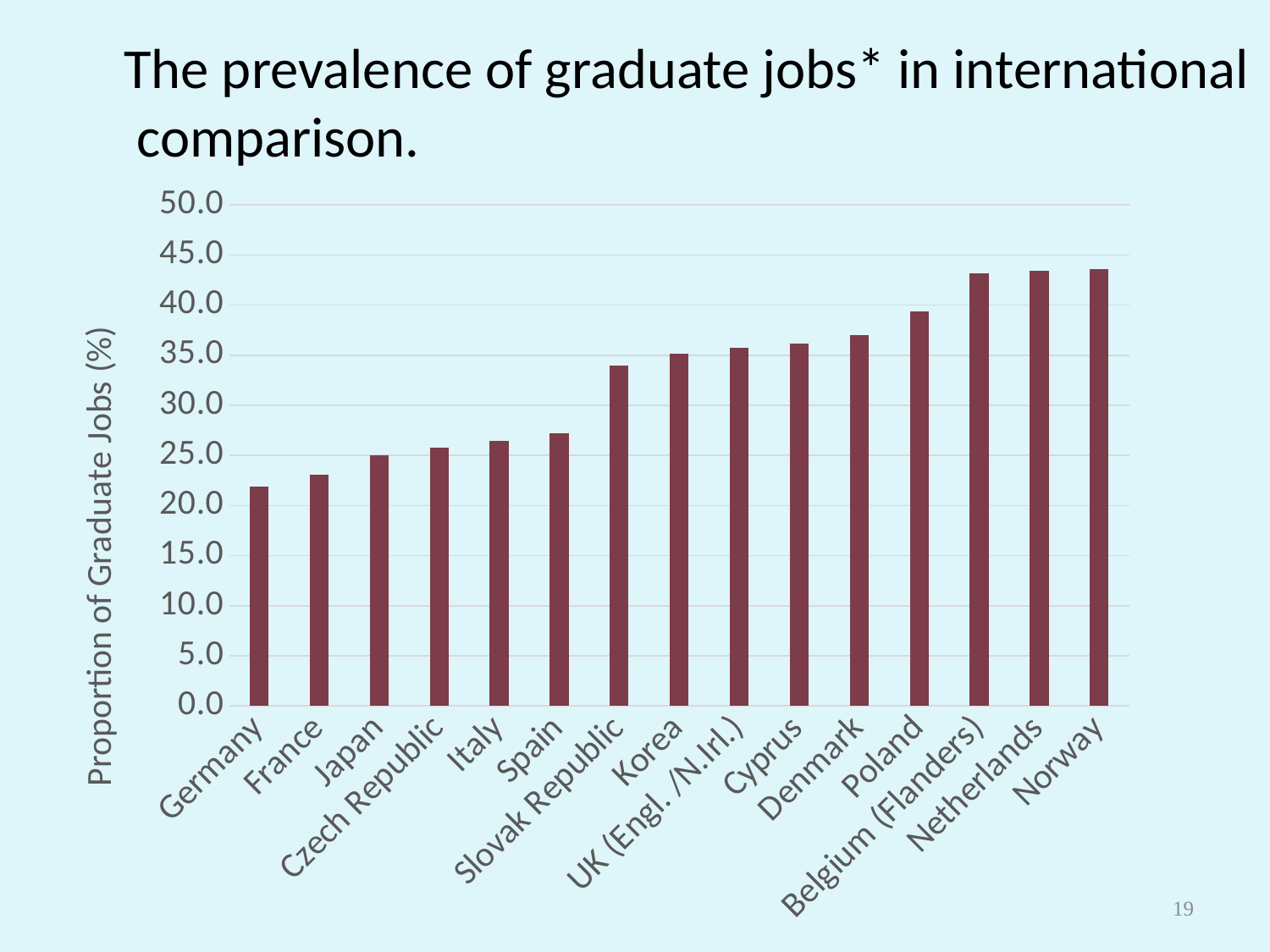
Which has a higher proportion of graduate jobs, Norway or Germany? Norway Is the value for Slovak Republic greater or less than 30.0? greater Which country has the lowest proportion of graduate jobs in the chart? Germany What is the label on the vertical axis of the chart? Proportion of Graduate Jobs (%) Is the value for Germany greater or less than 25.0? less Do the values rise or fall moving from left to right along the x axis? rise Is the value for Spain greater or less than 30.0? less How many countries are shown on the x axis of the chart? 15 What kind of chart is shown on the slide? bar chart Which has a higher proportion of graduate jobs, Poland or Spain? Poland